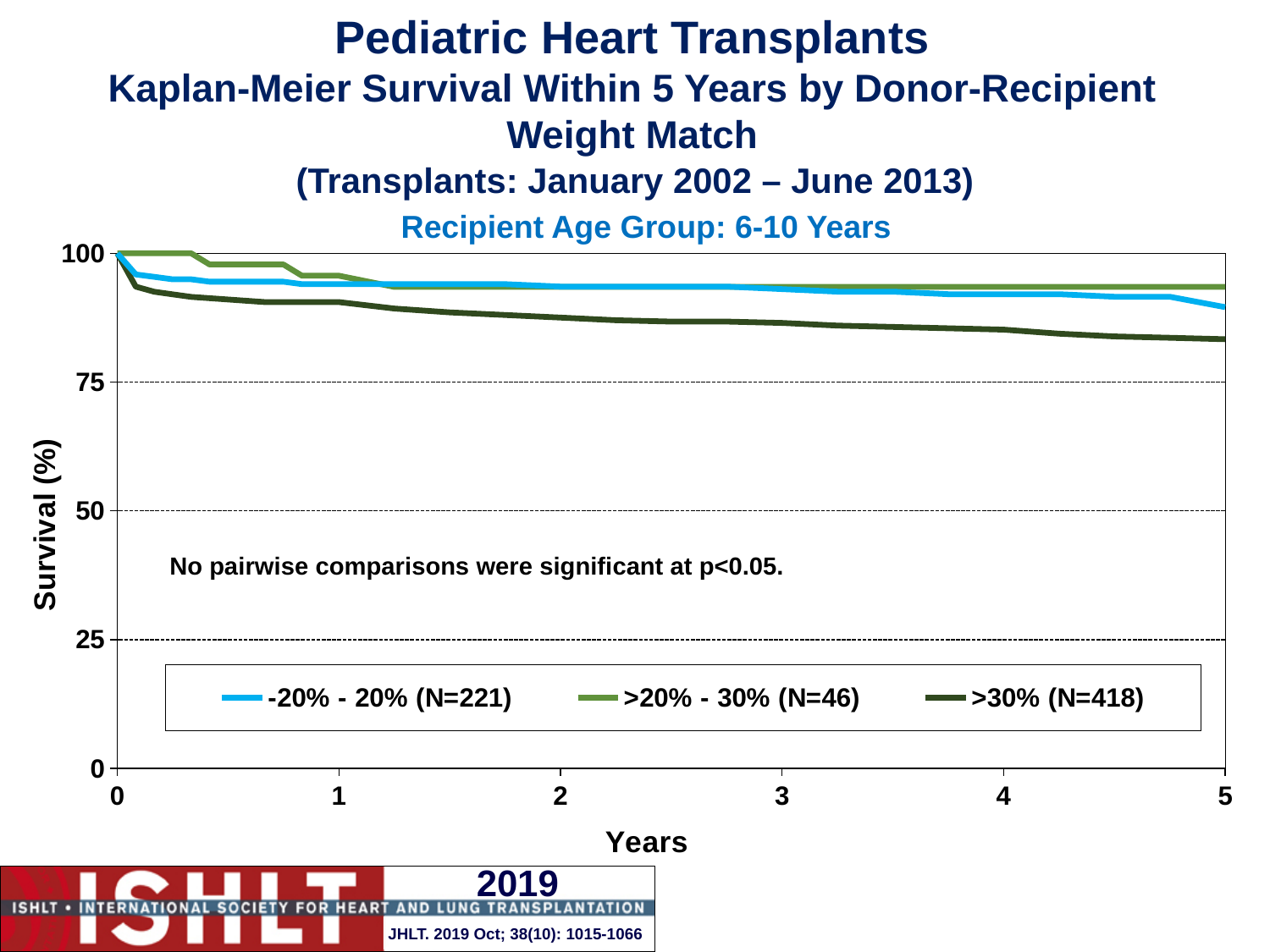
Which group has the lowest survival at 5 years? >30% (N=418) At 5 years, which has higher survival: the -20% - 20% (N=221) group or the >30% (N=418) group? -20% - 20% (N=221) How many series does the legend list? 3 Is the survival value for the >20% - 30% (N=46) group at 5 years greater or less than 75? greater Do the survival curves rise or fall as years increase along the x axis? Fall Is the survival value for the >30% (N=418) group at 5 years greater or less than 75? greater Is the survival value for the -20% - 20% (N=221) group at 5 years greater or less than 75? greater What is the recipient age group shown in the chart subtitle? 6-10 Years What kind of chart is shown on the slide? Line chart At 3 years, which has higher survival: the >20% - 30% (N=46) group or the >30% (N=418) group? >20% - 30% (N=46) What is the label on the y axis? Survival (%) What is the N for the >30% weight match group in the legend? 418